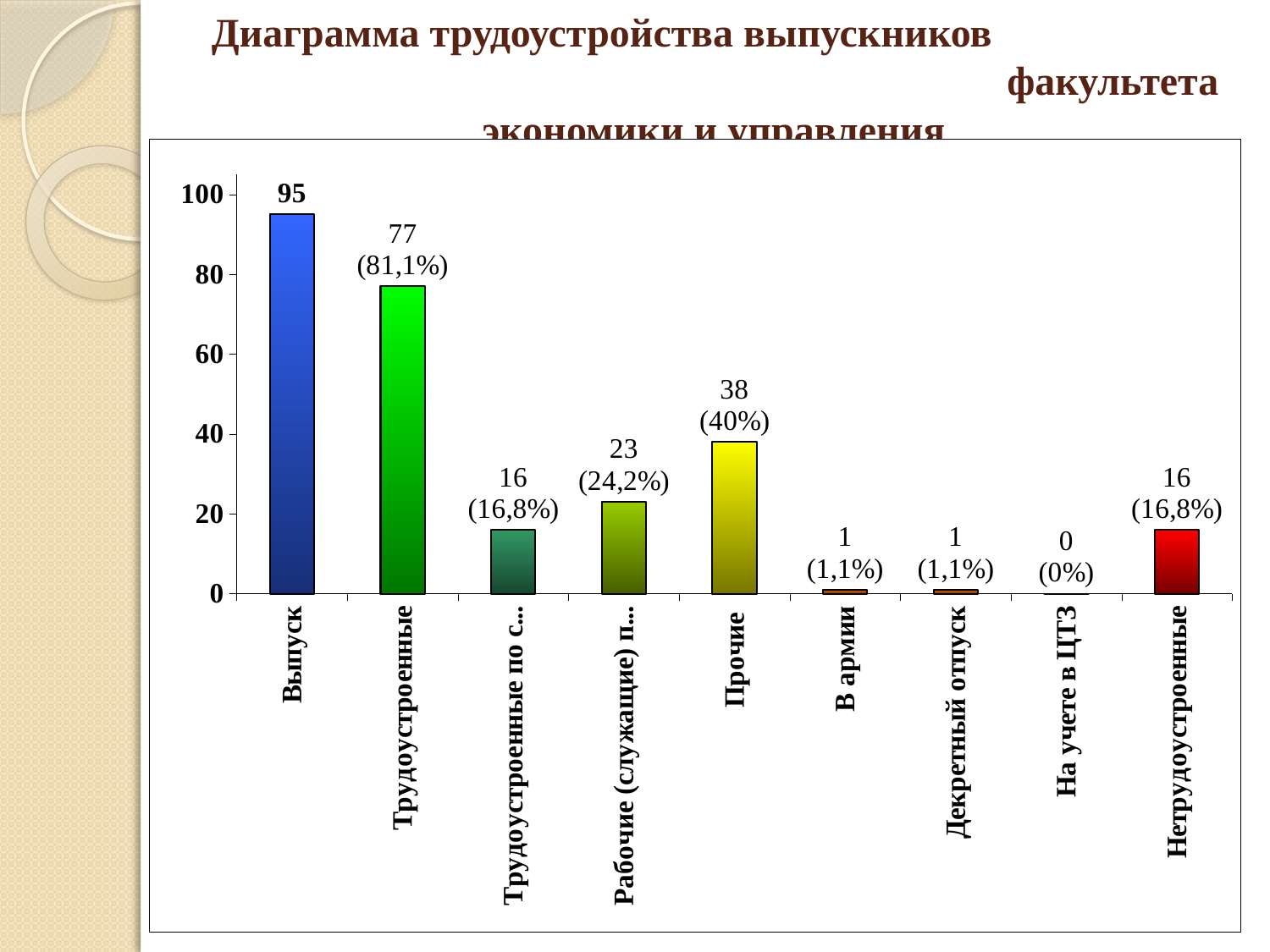
How many categories are shown on the x axis? 9 What is the value for Нетрудоустроенные? 16 Which category has the lowest value? На учете в ЦТЗ What is the value for Выпуск? 95 What is the difference between the values for Выпуск and Трудоустроенные? 18 What percentage is shown for Прочие? 40% What percentage is shown for Декретный отпуск? 1,1% What is the value for Трудоустроенные? 77 What is the value for В армии? 1 Which category has the highest value? Выпуск Which is larger, the value for Прочие or the value for Нетрудоустроенные? Прочие What kind of chart is shown on the slide? Bar chart